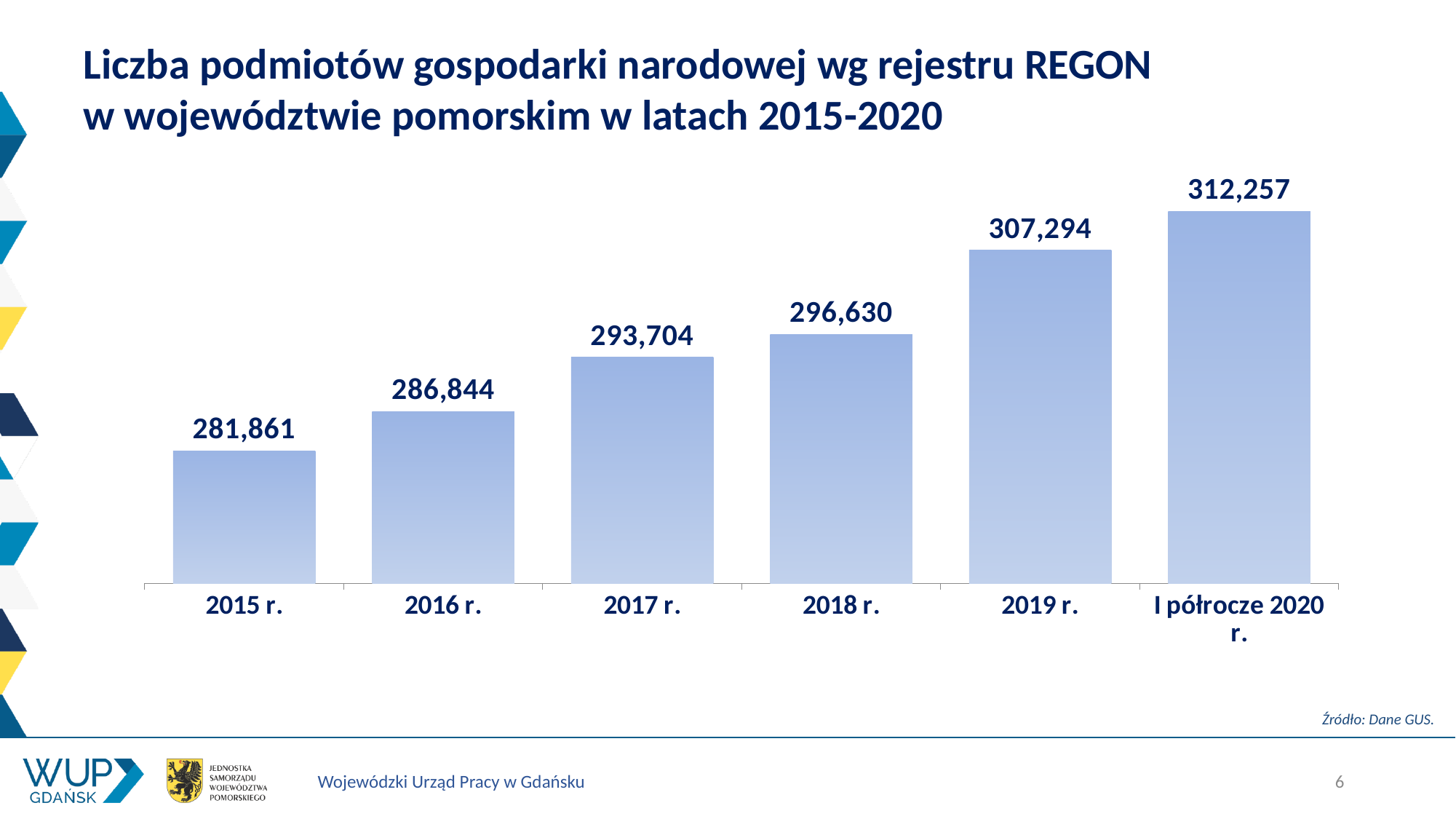
How many categories are shown on the x axis? 6 What is the value for 2015 r.? 281,861 What is the difference between the values for 2019 r. and 2018 r.? 10,664 Which category has the highest value? I półrocze 2020 r. Which is larger, the value for 2017 r. or the value for 2016 r.? 2017 r. Do the values rise or fall from 2015 r. to I półrocze 2020 r.? Rise What source is cited below the chart? Dane GUS What is the value for I półrocze 2020 r.? 312,257 What kind of chart is shown on the slide? Bar chart What is the difference between the values for I półrocze 2020 r. and 2015 r.? 30,396 Which category has the lowest value? 2015 r. What is the value for 2018 r.? 296,630